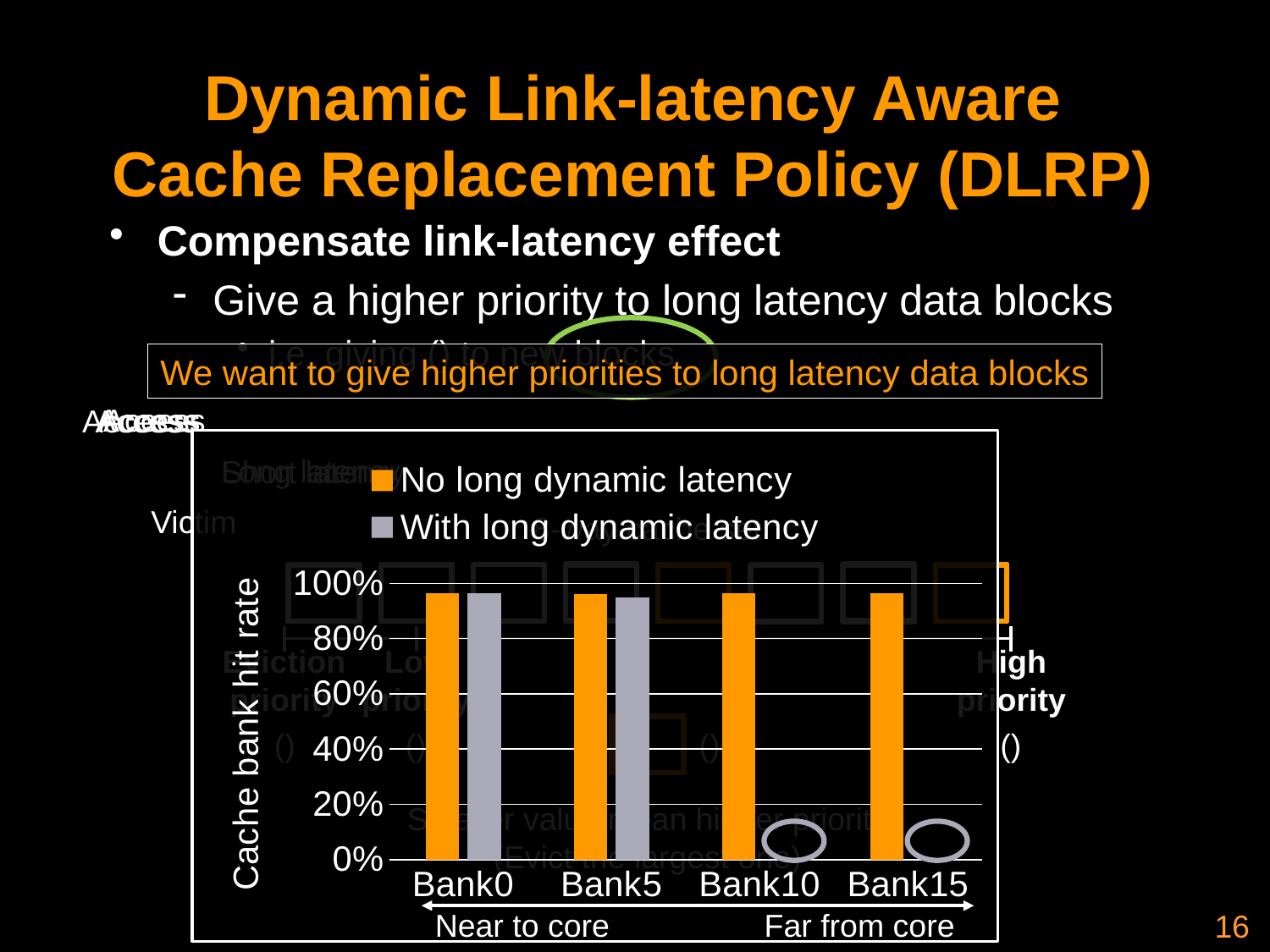
Is the 'No long dynamic latency' value for Bank0 greater or less than 80%? greater What is the label of the vertical axis of the chart? Cache bank hit rate What are the two series named in the chart legend? No long dynamic latency; With long dynamic latency How many series does the chart legend list? 2 For Bank10, which series has the larger value: 'No long dynamic latency' or 'With long dynamic latency'? No long dynamic latency What kind of chart is shown on the slide? bar chart How many categories (banks) are shown on the x axis of the chart? 4 Is the 'With long dynamic latency' value for Bank15 greater or less than 40%? less Is the 'With long dynamic latency' value for Bank5 greater or less than 60%? greater Do the 'With long dynamic latency' values rise or fall when moving from Bank0 to Bank15 along the x axis? fall For the 'With long dynamic latency' series, which is larger: Bank0 or Bank15? Bank0